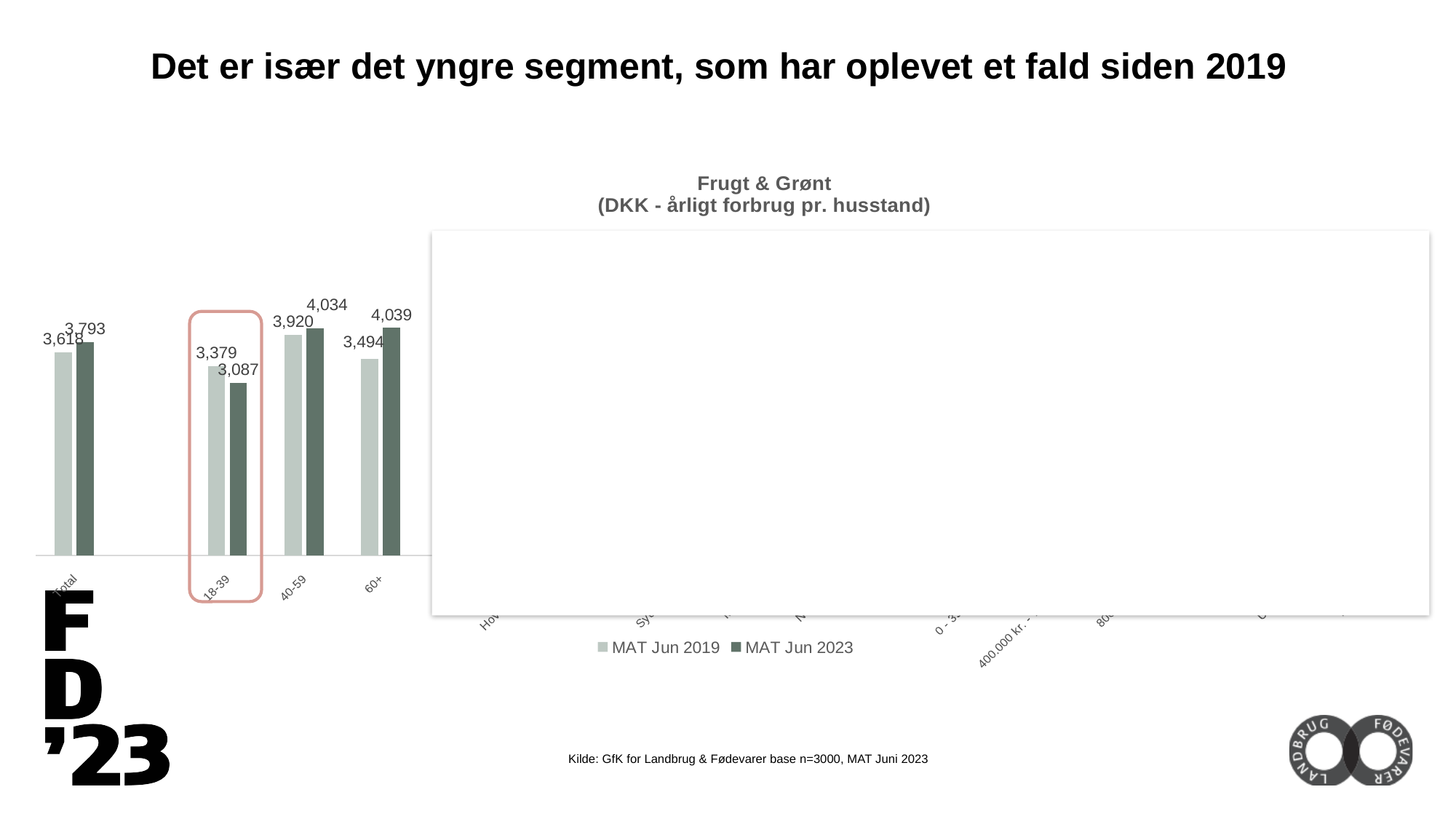
What kind of chart is the Frugt & Grønt chart? Bar chart By how much did the value for the 18-39 age group fall from MAT Jun 2019 to MAT Jun 2023 in the Frugt & Grønt chart? 292 What is the MAT Jun 2023 value for the 18-39 age group in the Frugt & Grønt chart? 3,087 Which age group is highlighted with a red outline in the Frugt & Grønt chart? 18-39 Among the visible categories, which has the lowest MAT Jun 2023 value in the Frugt & Grønt chart? 18-39 What is the MAT Jun 2019 value for the 60+ age group in the Frugt & Grønt chart? 3,494 Among the visible categories, which has the highest MAT Jun 2019 value in the Frugt & Grønt chart? 40-59 What is the MAT Jun 2019 value for the 18-39 age group in the Frugt & Grønt chart? 3,379 What is the MAT Jun 2023 value for the Total category in the Frugt & Grønt chart? 3,793 What is the difference between the MAT Jun 2023 and MAT Jun 2019 values for the 60+ age group in the Frugt & Grønt chart? 545 How many series does the legend of the Frugt & Grønt chart list? 2 For the 40-59 age group in the Frugt & Grønt chart, which is larger: the MAT Jun 2019 value or the MAT Jun 2023 value? MAT Jun 2023